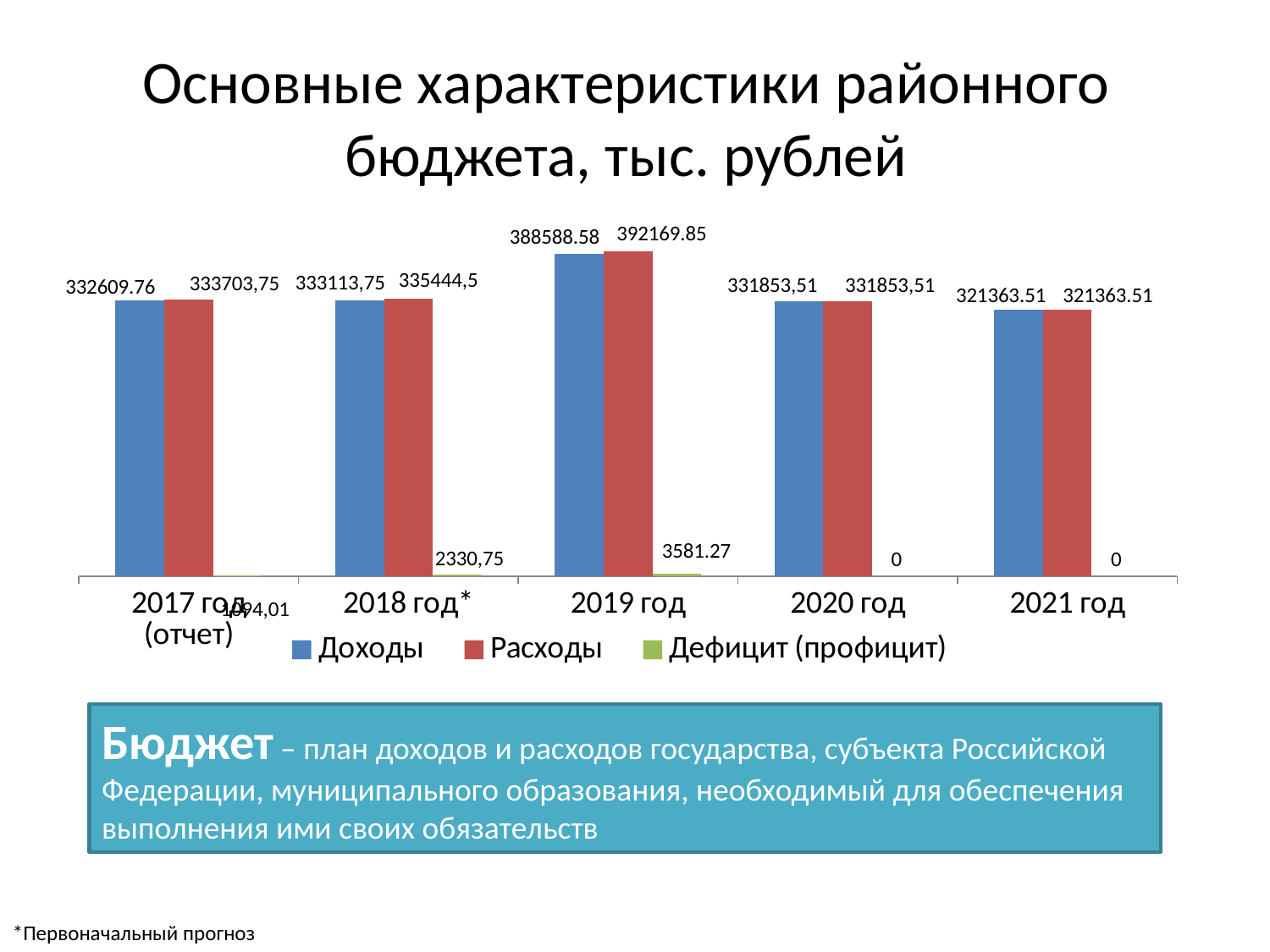
What is the value of Расходы for 2021 год? 321363.51 What is the difference between Расходы and Доходы for 2019 год? 3581.27 What is the value of Расходы for 2018 год*? 335444,5 In which year are Доходы the highest? 2019 год What is the value of Дефицит (профицит) for 2020 год? 0 What is the value of Доходы for 2019 год? 388588.58 Which is larger: Расходы for 2019 год or Расходы for 2020 год? Расходы for 2019 год How many year categories are shown on the x axis? 5 What kind of chart is shown on the slide? bar chart In which year are Расходы the lowest? 2021 год What is the value of Дефицит (профицит) for 2019 год? 3581.27 How many series does the legend list? 3